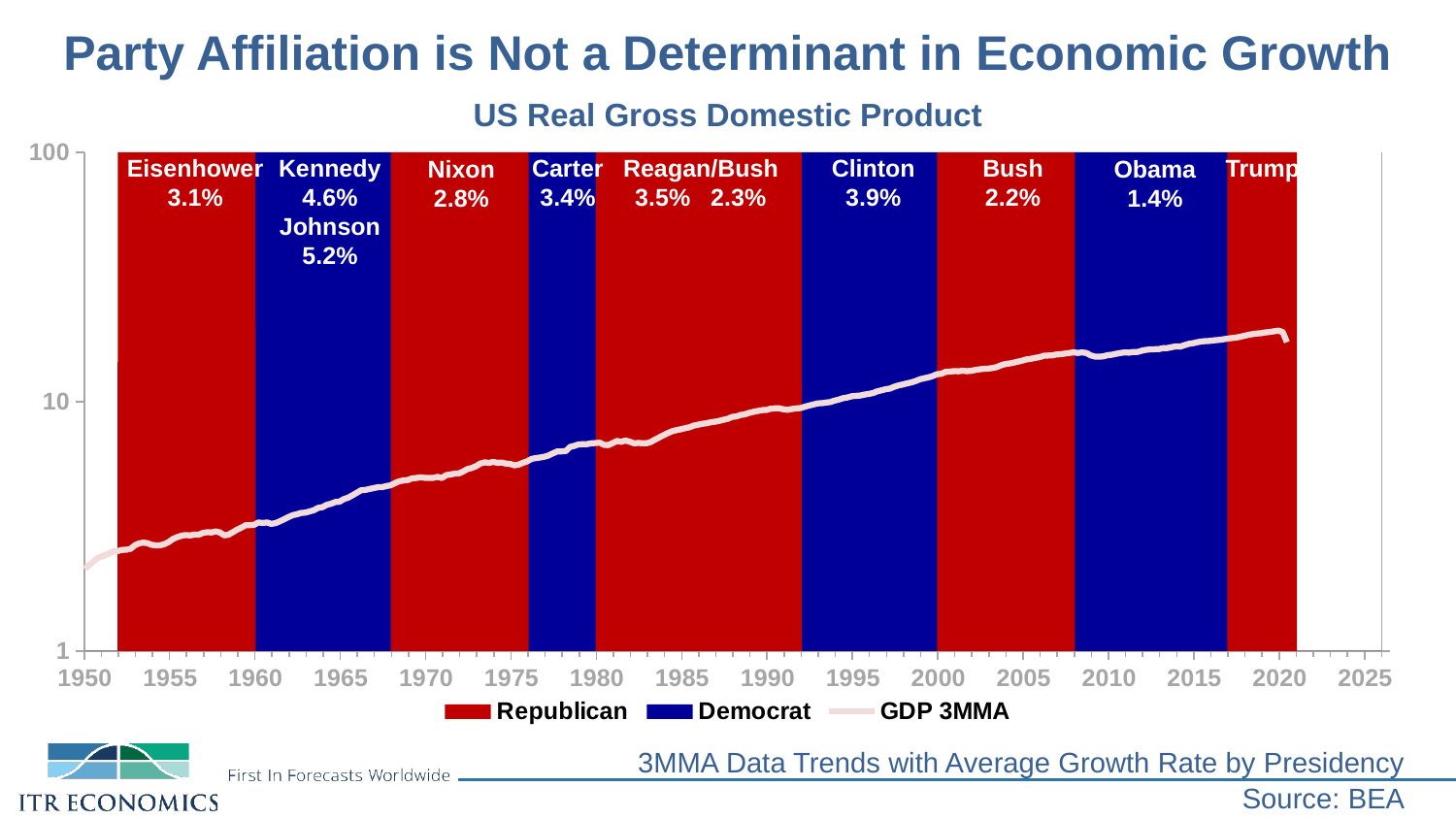
What is the title of the chart? US Real Gross Domestic Product Is the GDP 3MMA value in 1970 greater or less than 10? less How many entries does the legend list? 3 What is the average growth rate shown for the Obama presidency? 1.4% What is the average growth rate shown for the Nixon presidency? 2.8% Which presidency has the highest average growth rate printed on the chart? Johnson (5.2%) Does the GDP 3MMA line generally rise or fall from 1950 to 2020? rise Which has the higher average growth rate, Kennedy or Nixon? Kennedy Which presidency has the lowest average growth rate printed on the chart? Obama (1.4%) What is the difference between the Johnson growth rate and the Obama growth rate? 3.8% What is the average growth rate shown for the Clinton presidency? 3.9% Is the GDP 3MMA value in 2000 greater or less than 10? greater